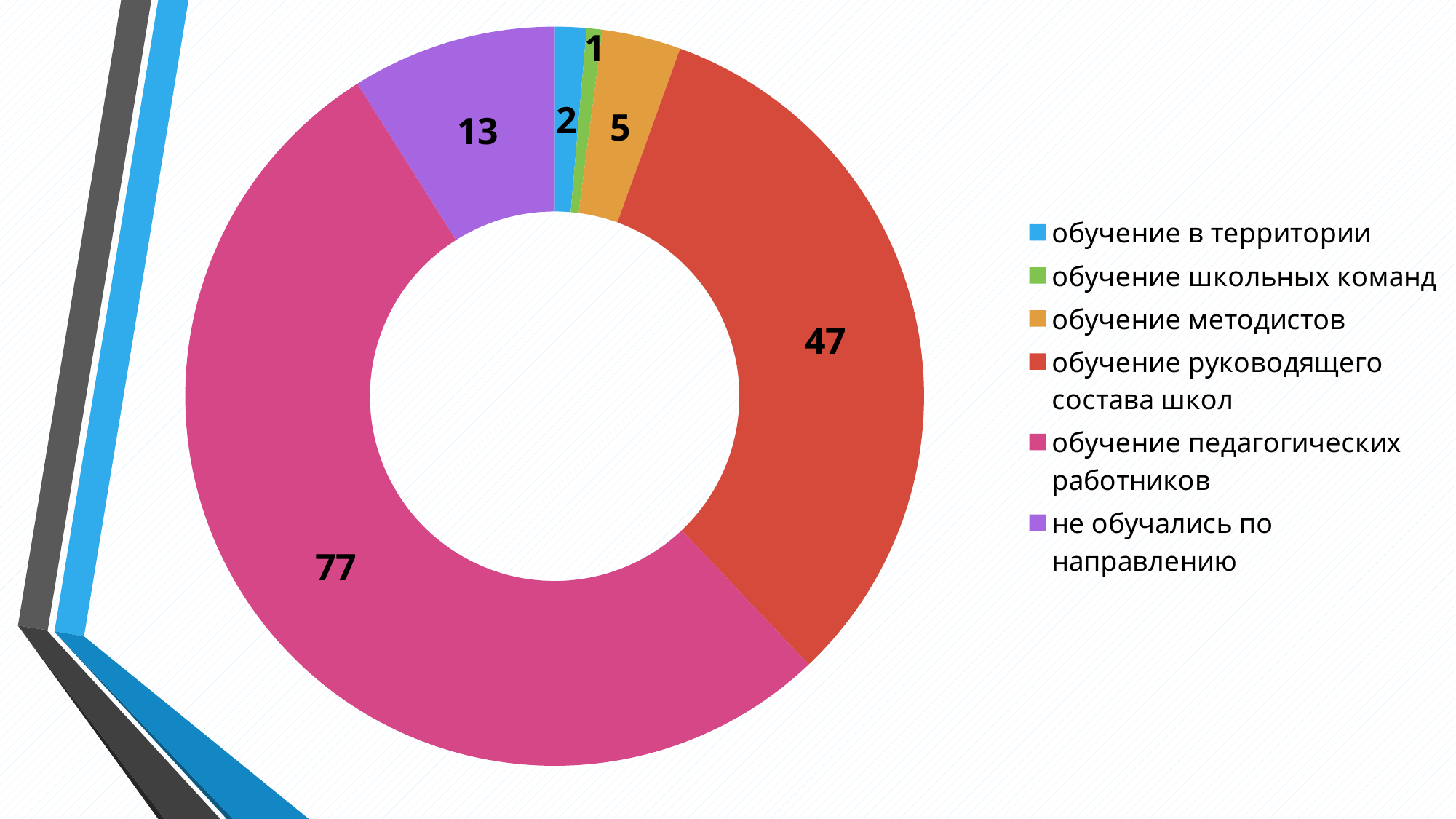
Which is larger: the value for не обучались по направлению or the value for обучение методистов? не обучались по направлению What value is shown for обучение школьных команд? 1 What value is shown for не обучались по направлению? 13 What value is shown for обучение руководящего состава школ? 47 What colour is the slice for обучение руководящего состава школ? red What value is shown for обучение методистов? 5 What kind of chart is shown on the slide? doughnut chart How many categories does the chart show? 6 What is the difference between the values for обучение педагогических работников and обучение руководящего состава школ? 30 Which category has the smallest value? обучение школьных команд Which category has the largest value? обучение педагогических работников What value is shown for обучение педагогических работников? 77